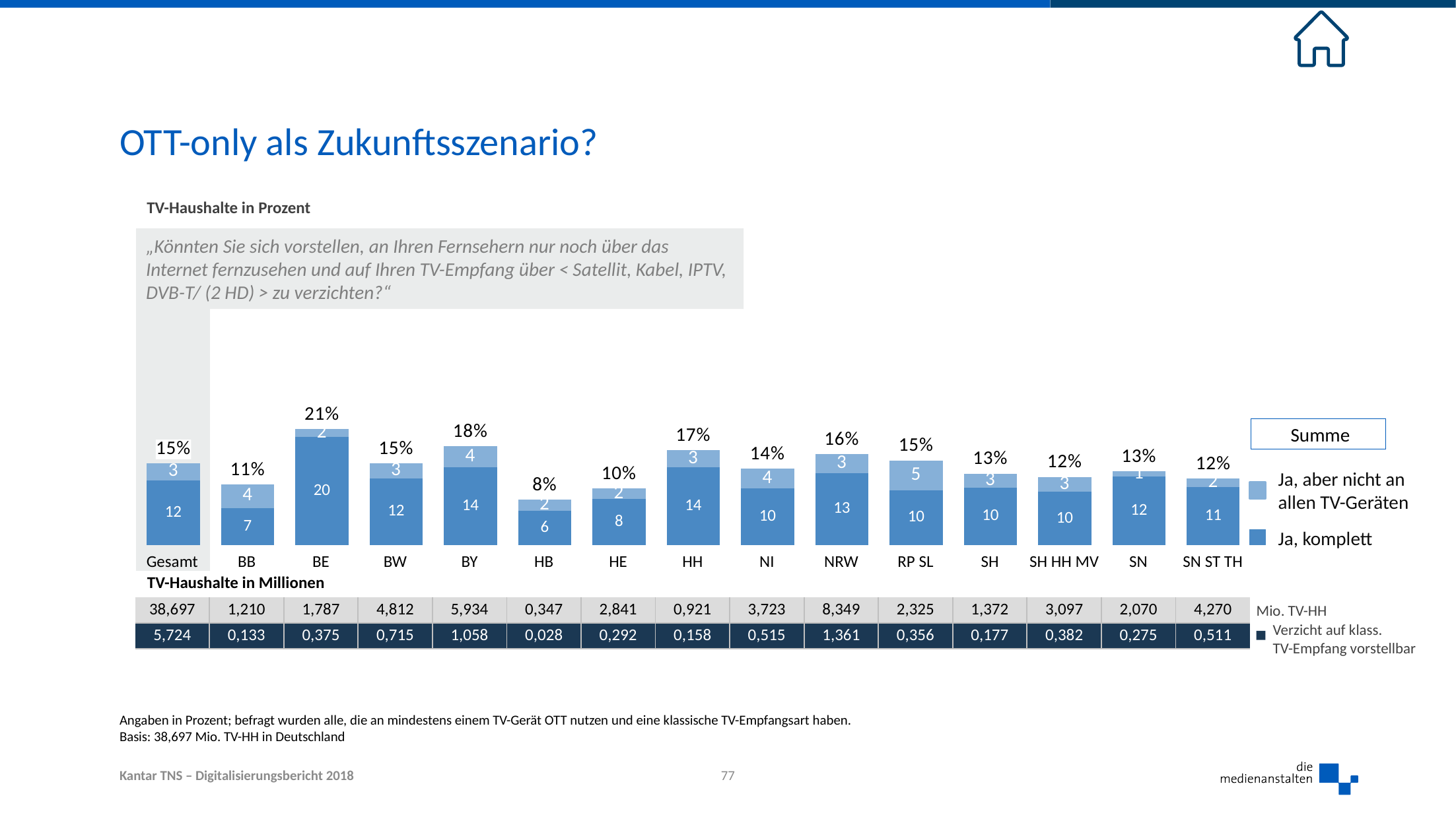
Which category has the highest total percentage? BE What kind of chart is shown on the slide? Stacked bar chart What is the total percentage shown above the bar for BY? 18% What is the 'Ja, komplett' value for BE? 20 How many series does the legend list? 2 What is the 'Verzicht auf klass. TV-Empfang vorstellbar' value shown in the table for Gesamt? 5,724 Which category has the lowest total percentage? HB Which has a larger 'Ja, komplett' value, HH or NI? HH What is the 'Mio. TV-HH' value shown in the table for NRW? 8,349 How many categories are shown on the x axis of the bar chart? 15 What is the 'Ja, aber nicht an allen TV-Geräten' value for RP SL? 5 What is the difference between the total percentage for BE and the total percentage for HB? 13%